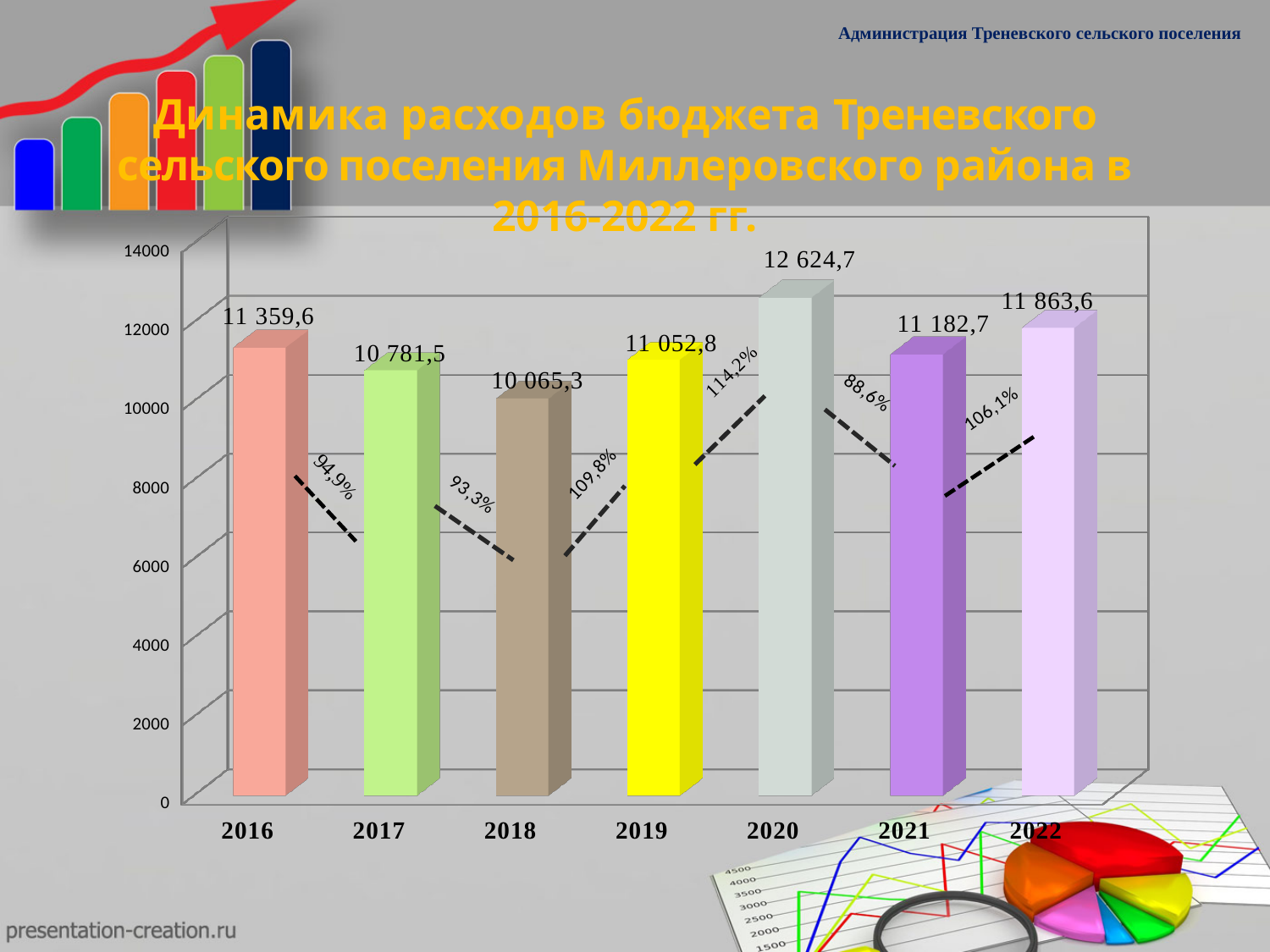
Which year has the lowest value? 2018 What is the value for 2022? 11 863,6 What is the value for 2020? 12 624,7 What is the value for 2016? 11 359,6 What is the difference between the values for 2020 and 2016? 1 265,1 Which year has the highest value? 2020 Which is larger, the value for 2019 or the value for 2017? 2019 How many years are shown on the x axis? 7 What is the difference between the values for 2022 and 2021? 680,9 Do the values rise or fall from 2016 to 2018? fall What kind of chart is this? bar chart Is the value for 2020 greater or less than 12000? greater